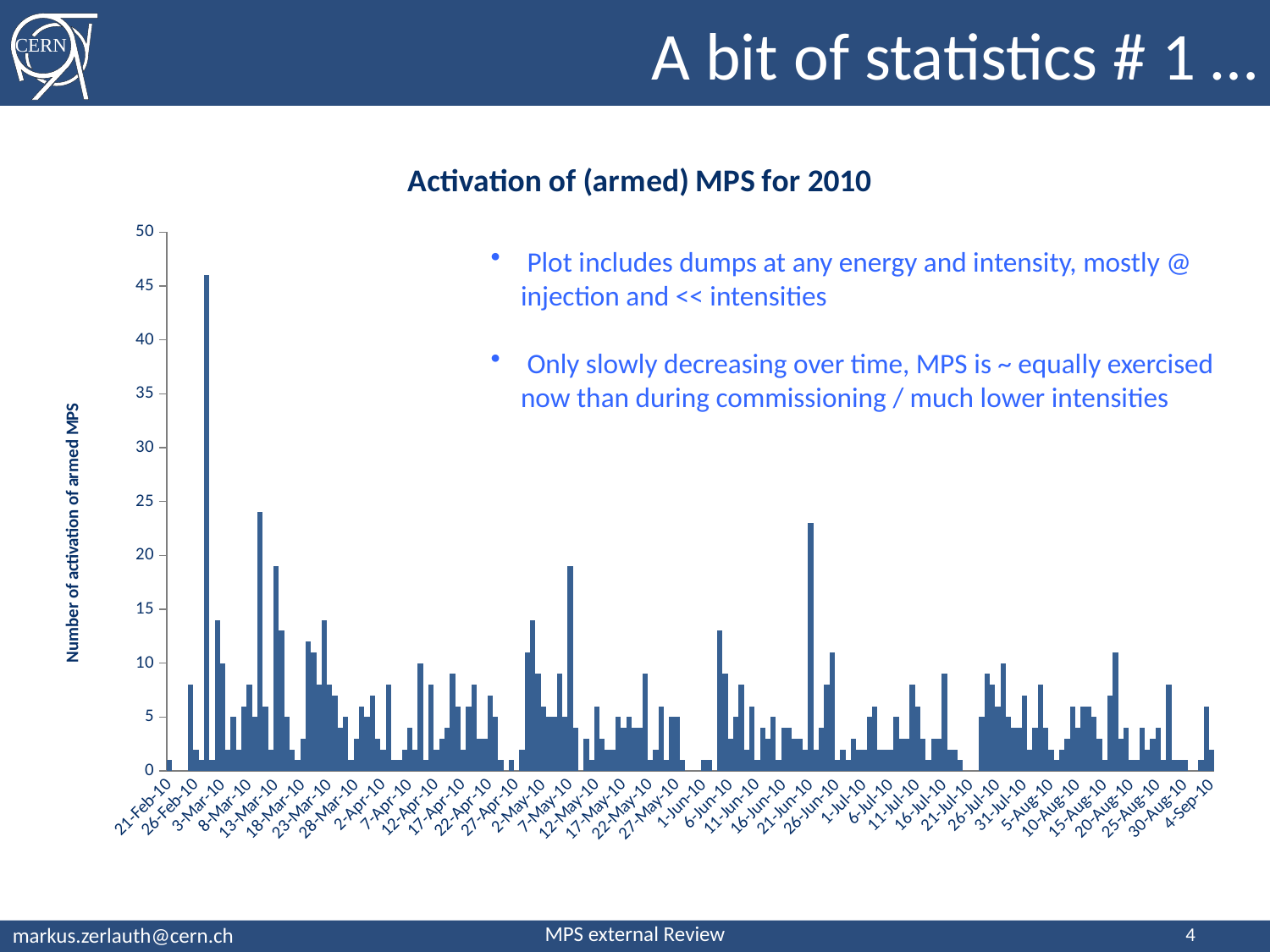
Is the tallest bar in the chart greater or less than 50? less What is the maximum value shown on the vertical axis of the chart? 50 What is the label of the vertical axis of the chart? Number of activation of armed MPS Is the tall bar near 7-May-10 greater or less than 15? greater Is the tall bar near 13-Mar-10 greater or less than 20? greater Overall, do the bar heights tend to rise or fall from left to right across the chart? fall What is the first date label on the horizontal axis of the chart? 21-Feb-10 What type of chart is shown on the slide? Bar chart What is the title of the chart? Activation of (armed) MPS for 2010 What is the last date label on the horizontal axis of the chart? 4-Sep-10